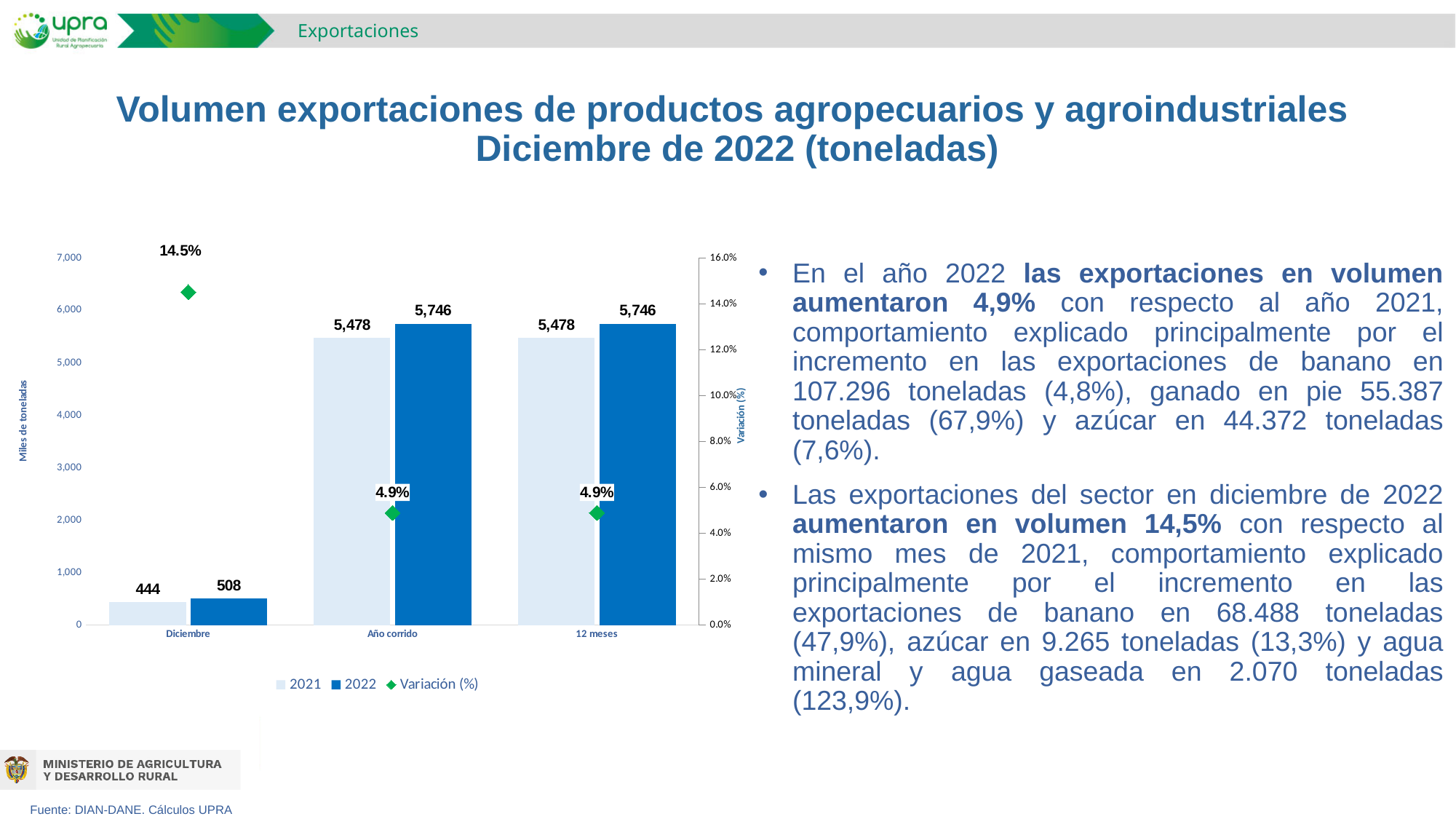
Which category has the lowest 2022 value? Diciembre What is the difference between the 2022 and 2021 values for Año corrido? 268 What is the 2022 value for Diciembre? 508 Is the 2021 value for Diciembre larger or smaller than the 2022 value for Diciembre? smaller How many series does the legend list? 3 What is the 2021 value for Año corrido? 5,478 What is the Variación (%) value for 12 meses? 4.9% What is the difference between the 2022 and 2021 values for Diciembre? 64 What is the Variación (%) value for Diciembre? 14.5% Which category has the highest Variación (%) value? Diciembre What is the label of the left vertical axis? Miles de toneladas How many categories are shown on the x axis? 3